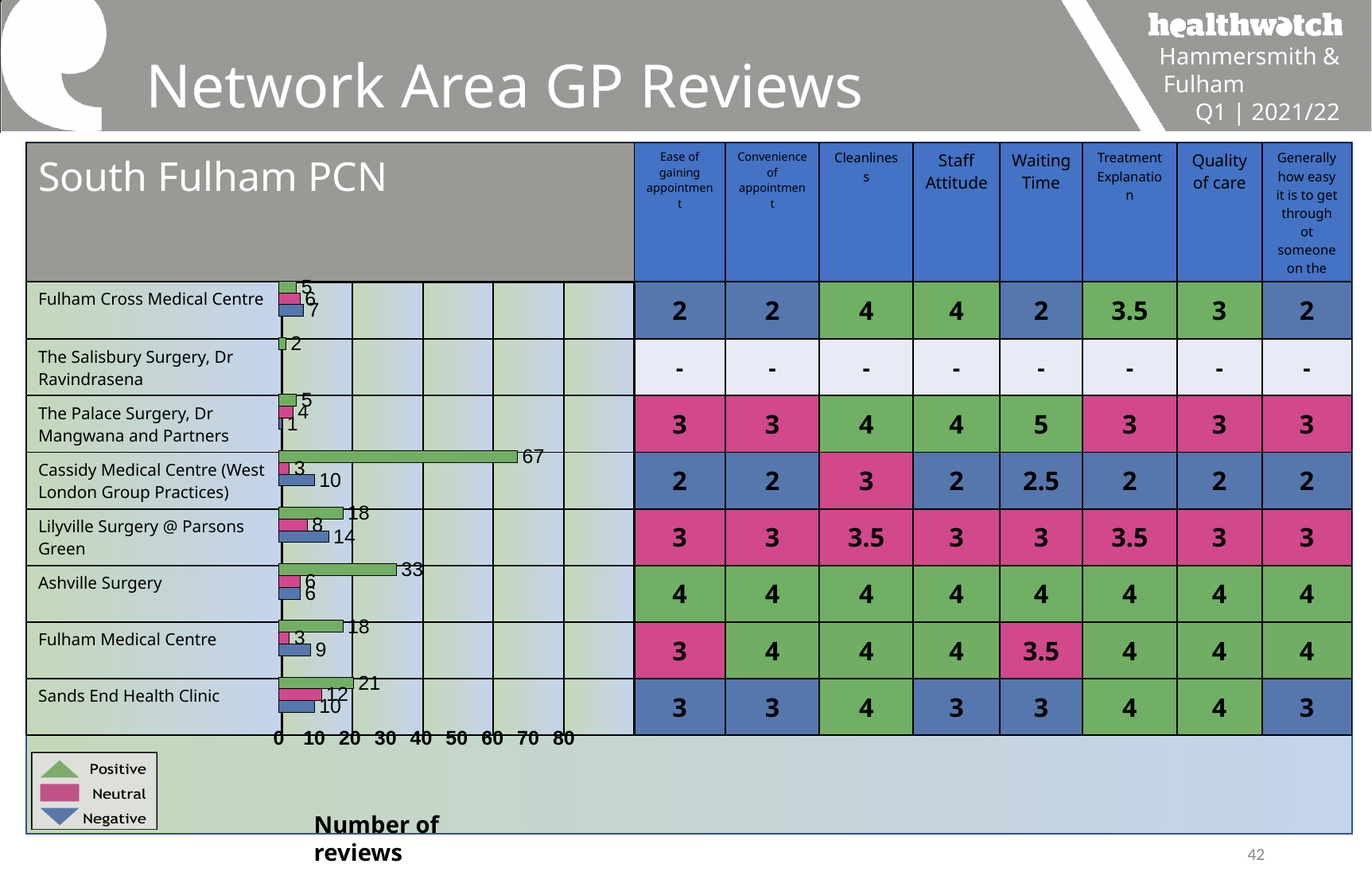
How many practices are shown in the bar chart? 8 How many Neutral reviews does Sands End Health Clinic have in the bar chart? 12 What is the total number of reviews (Positive, Neutral and Negative) for Fulham Cross Medical Centre? 18 What is the difference between the Positive and Negative review counts for Sands End Health Clinic? 11 How many Positive reviews does Cassidy Medical Centre (West London Group Practices) have in the bar chart? 67 How many series does the chart legend list? 3 Which practice has the highest number of Neutral reviews in the bar chart? Sands End Health Clinic What kind of chart is used to show the number of reviews? bar chart Which has more Positive reviews, Ashville Surgery or Sands End Health Clinic? Ashville Surgery How many Negative reviews does Lilyville Surgery @ Parsons Green have in the bar chart? 14 Which practice has the highest number of Positive reviews in the bar chart? Cassidy Medical Centre (West London Group Practices) Is the Positive review count for Cassidy Medical Centre (West London Group Practices) greater or less than 60? greater